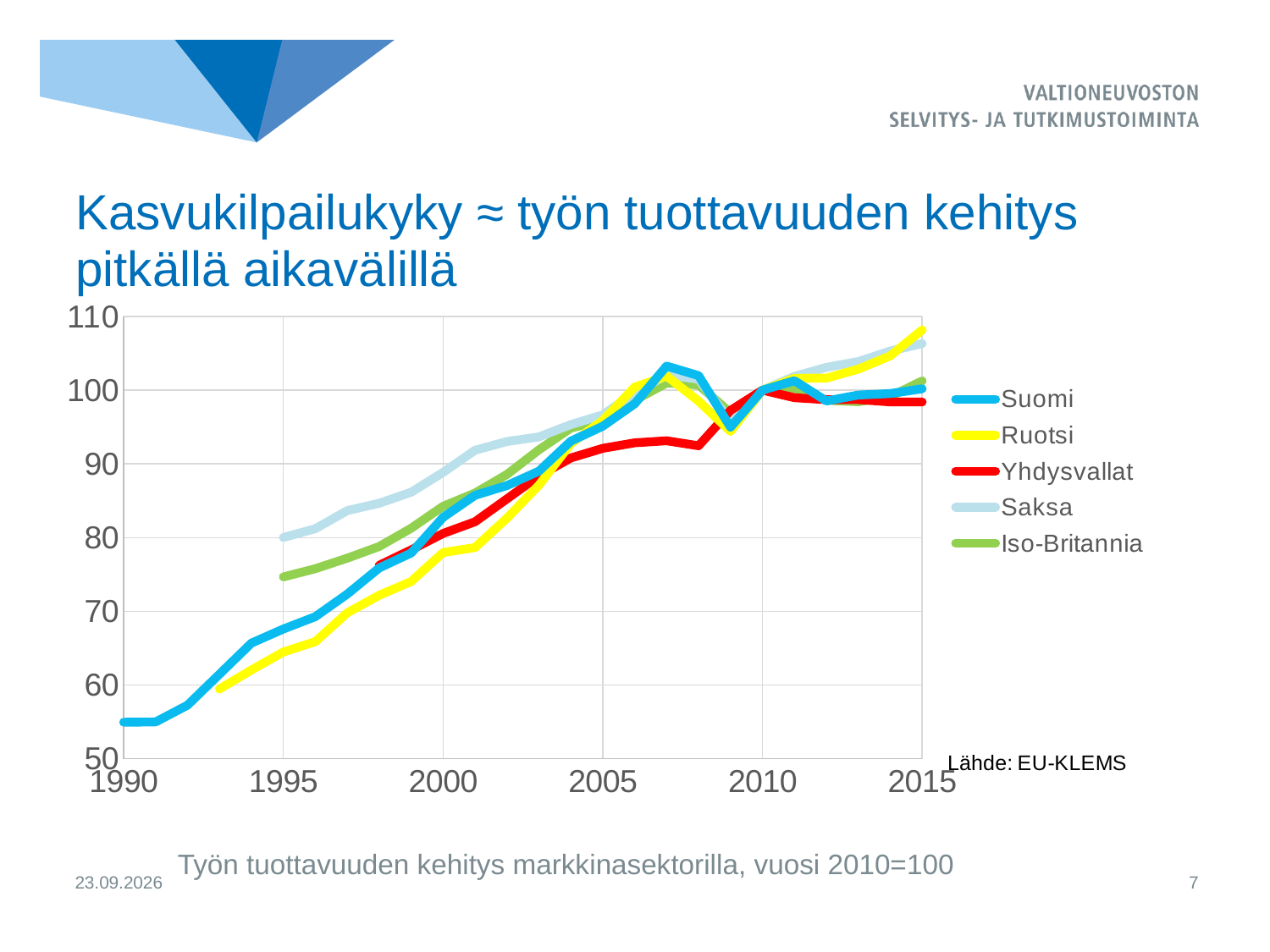
Is the value for Ruotsi in 2015 greater or less than 100? greater Which series has the highest value in 2015? Ruotsi Is the value for Iso-Britannia in 1995 greater or less than 80? less Is the value for Suomi in 1990 greater or less than 60? less How many series does the chart's legend list? 5 What is the index value of the series in the year 2010? 100 Does the Suomi series generally rise or fall from 1990 to 2015? rise What kind of chart is shown on the slide? line chart Which series is shown in red in the chart? Yhdysvallat In 2000, which is larger: the value for Saksa or the value for Suomi? Saksa What source is cited for the chart's data? EU-KLEMS